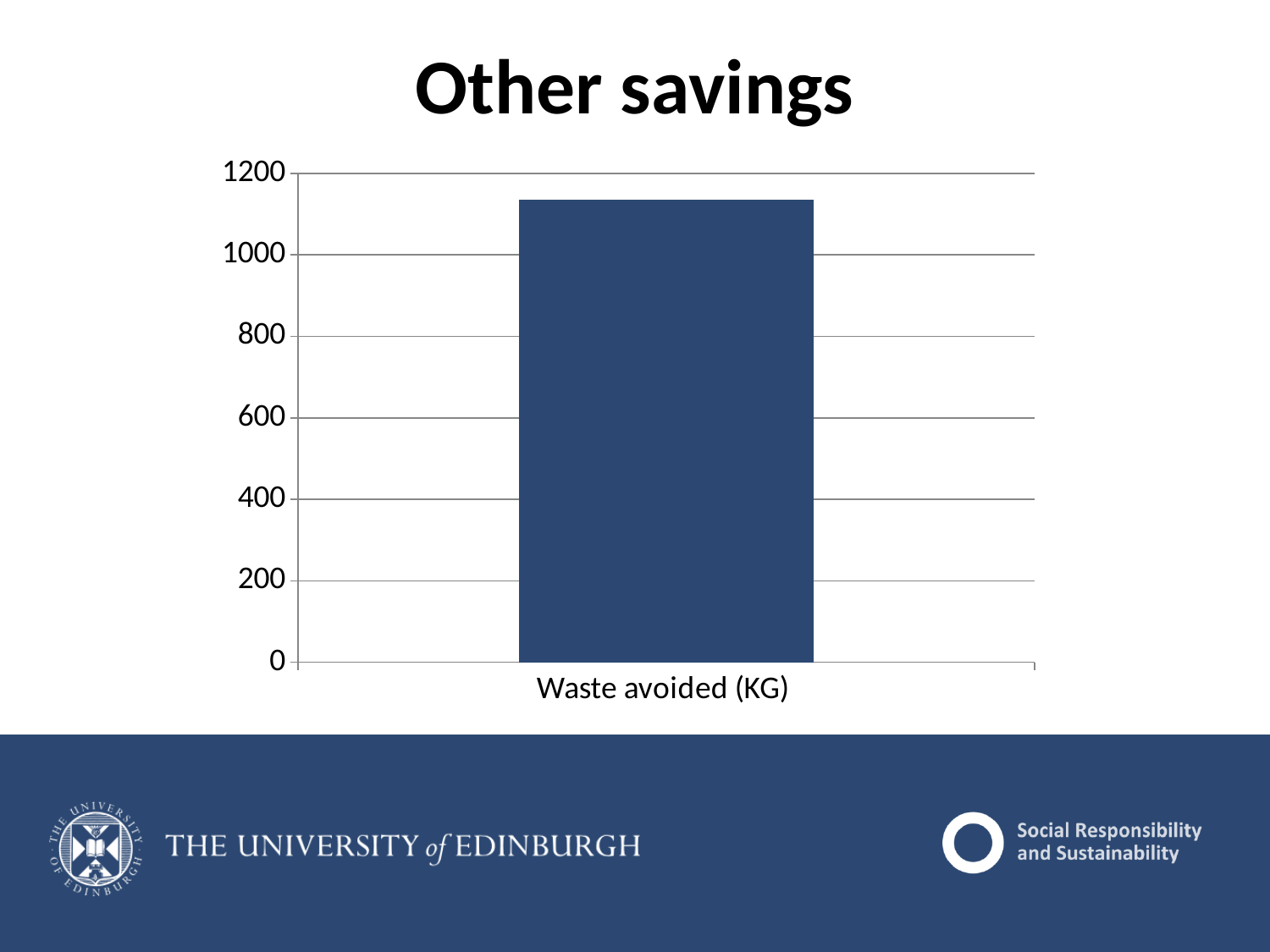
What is the category label on the x axis of the chart? Waste avoided (KG) What is the title of the slide containing the chart? Other savings What kind of chart is shown on the slide? bar chart What is the highest value shown on the y axis of the chart? 1200 How many bars does the chart show? 1 Is the value for Waste avoided (KG) greater or less than 1000? greater Is the value for Waste avoided (KG) greater or less than 800? greater Is the value for Waste avoided (KG) greater or less than 1200? less